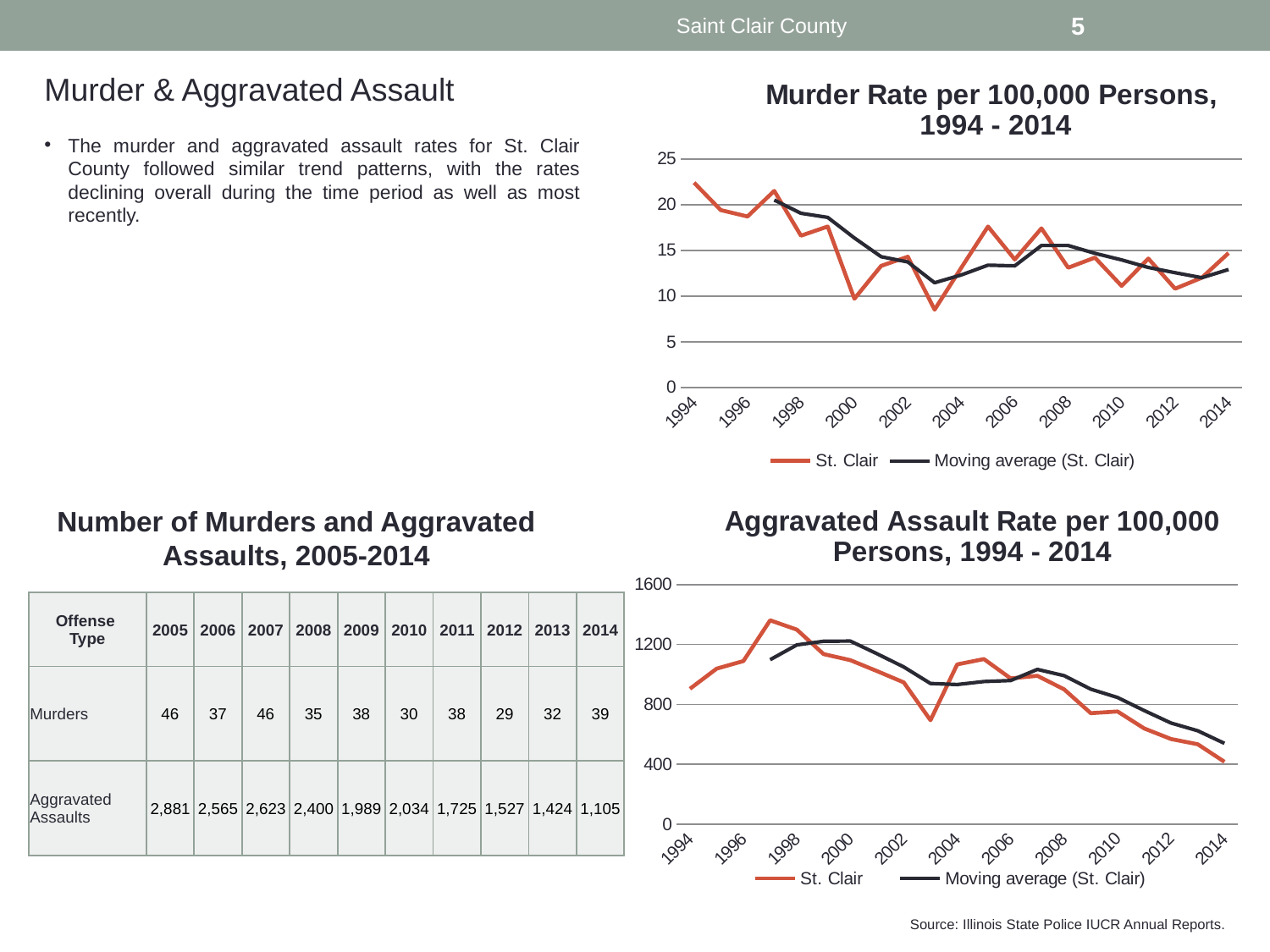
In the 'Murder Rate per 100,000 Persons, 1994 - 2014' chart, is the St. Clair value for 2003 greater or less than 10? less In the 'Murder Rate per 100,000 Persons, 1994 - 2014' chart, which year has the highest St. Clair murder rate? 1994 In the 'Murder Rate per 100,000 Persons, 1994 - 2014' chart, is the St. Clair value for 1994 greater or less than 20? greater What kind of chart is the 'Aggravated Assault Rate per 100,000 Persons, 1994 - 2014' chart? line chart How many series does the legend of the 'Murder Rate per 100,000 Persons, 1994 - 2014' chart list? 2 In the 'Aggravated Assault Rate per 100,000 Persons, 1994 - 2014' chart, does the St. Clair aggravated assault rate generally rise or fall from 1997 to 2014? fall What kind of chart is the 'Murder Rate per 100,000 Persons, 1994 - 2014' chart? line chart In the 'Aggravated Assault Rate per 100,000 Persons, 1994 - 2014' chart, is the St. Clair value for 2014 greater or less than 800? less In the 'Murder Rate per 100,000 Persons, 1994 - 2014' chart, which year has the lowest St. Clair murder rate? 2003 In the 'Aggravated Assault Rate per 100,000 Persons, 1994 - 2014' chart, which year has the highest St. Clair aggravated assault rate? 1997 In the 'Aggravated Assault Rate per 100,000 Persons, 1994 - 2014' chart, which year has the lowest St. Clair aggravated assault rate? 2014 In the 'Aggravated Assault Rate per 100,000 Persons, 1994 - 2014' chart, what are the two legend entries? St. Clair; Moving average (St. Clair)